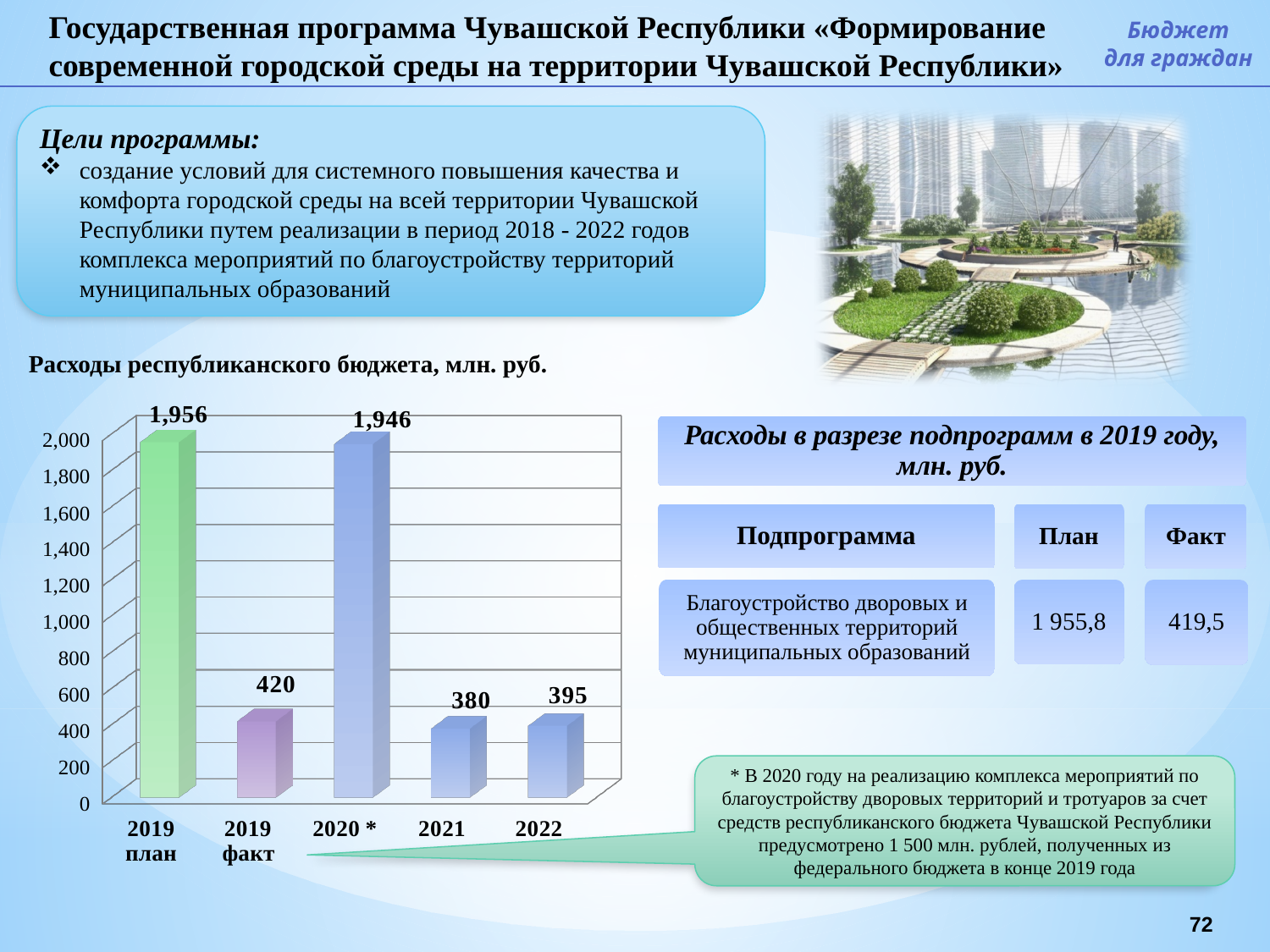
What is the value for 2021? 380 What is the title of the chart? Расходы республиканского бюджета, млн. руб. What is the difference between the values for 2019 план and 2019 факт? 1,536 Which category has the lowest value? 2021 What is the value for 2019 план? 1,956 What kind of chart is shown? bar chart What is the value for 2022? 395 What is the value for 2019 факт? 420 Which category has the highest value? 2019 план Which is larger, the value for 2019 факт or the value for 2022? 2019 факт How many categories are shown on the x axis? 5 What is the value for 2020 *? 1,946